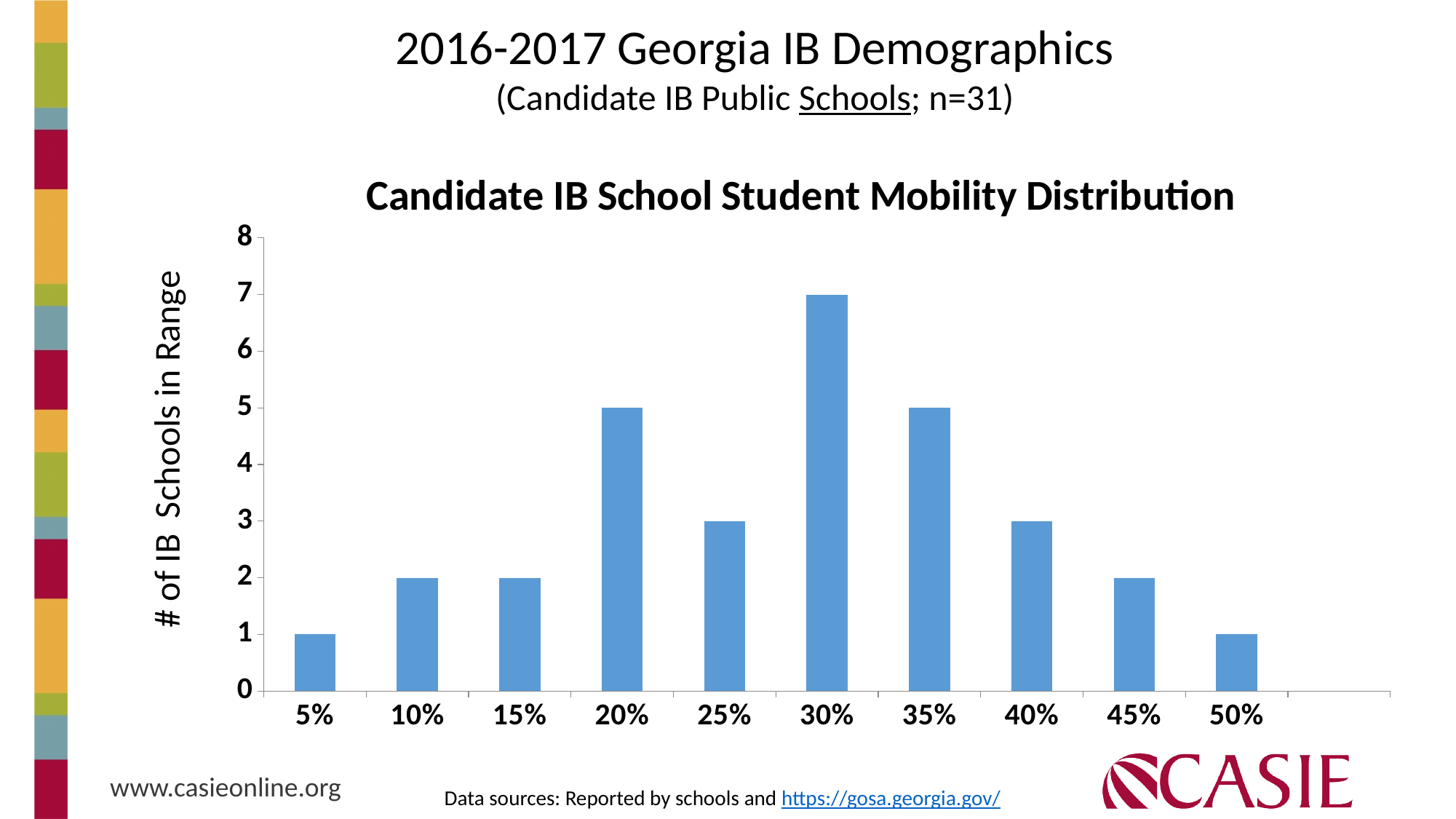
What is the label of the y axis? # of IB Schools in Range What is the title of the chart? Candidate IB School Student Mobility Distribution What kind of chart is shown on the slide? Bar chart Is the value for the 20% range greater or less than 4? greater What is the difference between the number of schools in the 30% range and the 35% range? 2 Which mobility range has the highest number of IB schools? 30% How many mobility ranges (categories) are shown on the x axis? 10 How many IB schools are in the 20% range? 5 How many IB schools are in the 30% range? 7 How many IB schools are in the 40% range? 3 Which has more IB schools, the 25% range or the 45% range? 25% How many IB schools are in the 50% range? 1